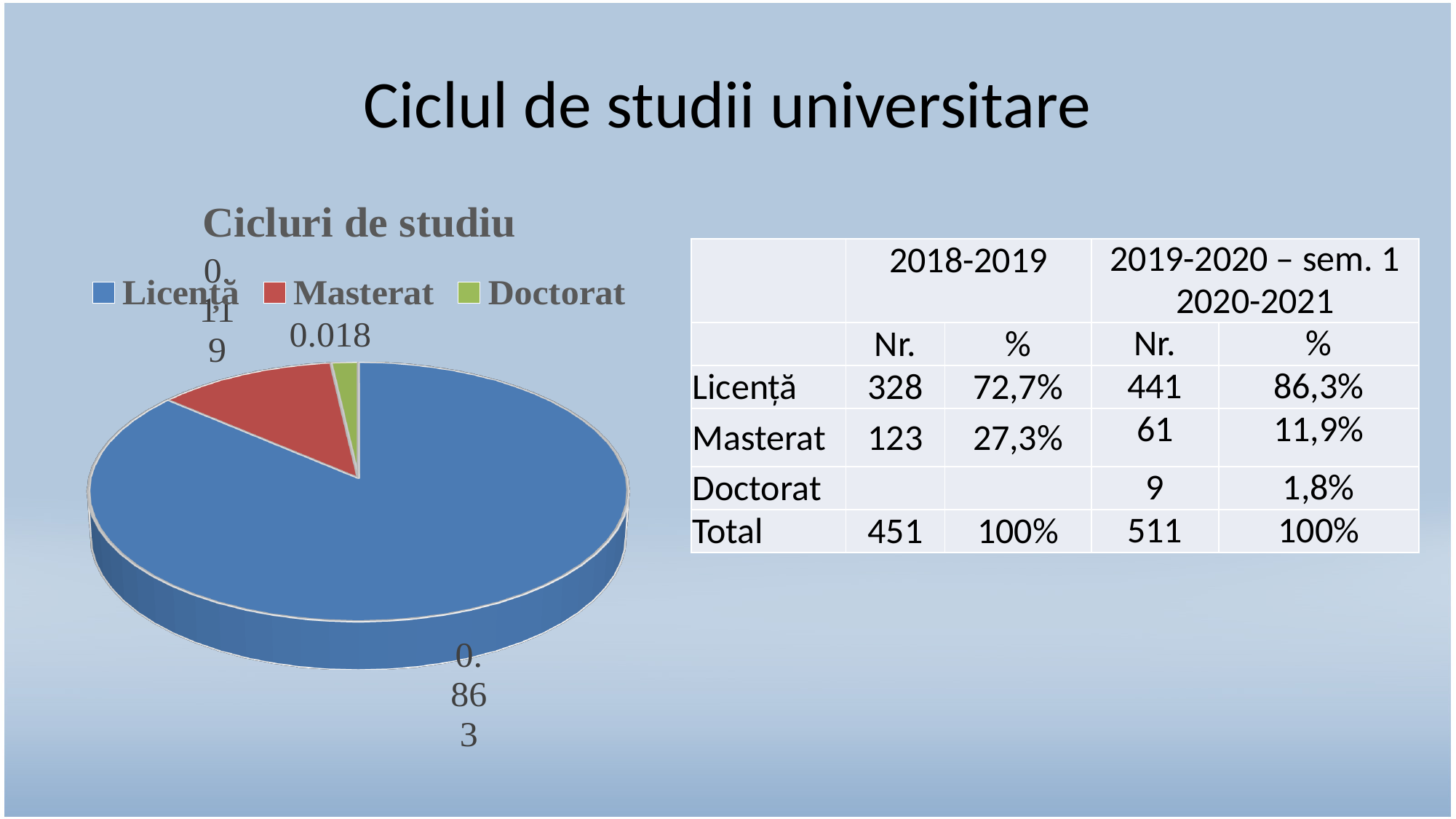
What is the difference between the labelled values for Licență and Doctorat in the pie chart? 0.845 What value is labelled on the Doctorat slice of the pie chart? 0.018 What colour is the Masterat slice in the pie chart? red What kind of chart is shown on the slide? pie chart How many slices does the pie chart have? 3 Which category has the largest slice in the pie chart? Licență How many entries does the chart legend list? 3 What value is labelled on the Licență slice of the pie chart? 0.863 Which category has the smallest slice in the pie chart? Doctorat Which slice is larger in the pie chart, Masterat or Doctorat? Masterat What is the title of the chart? Cicluri de studiu